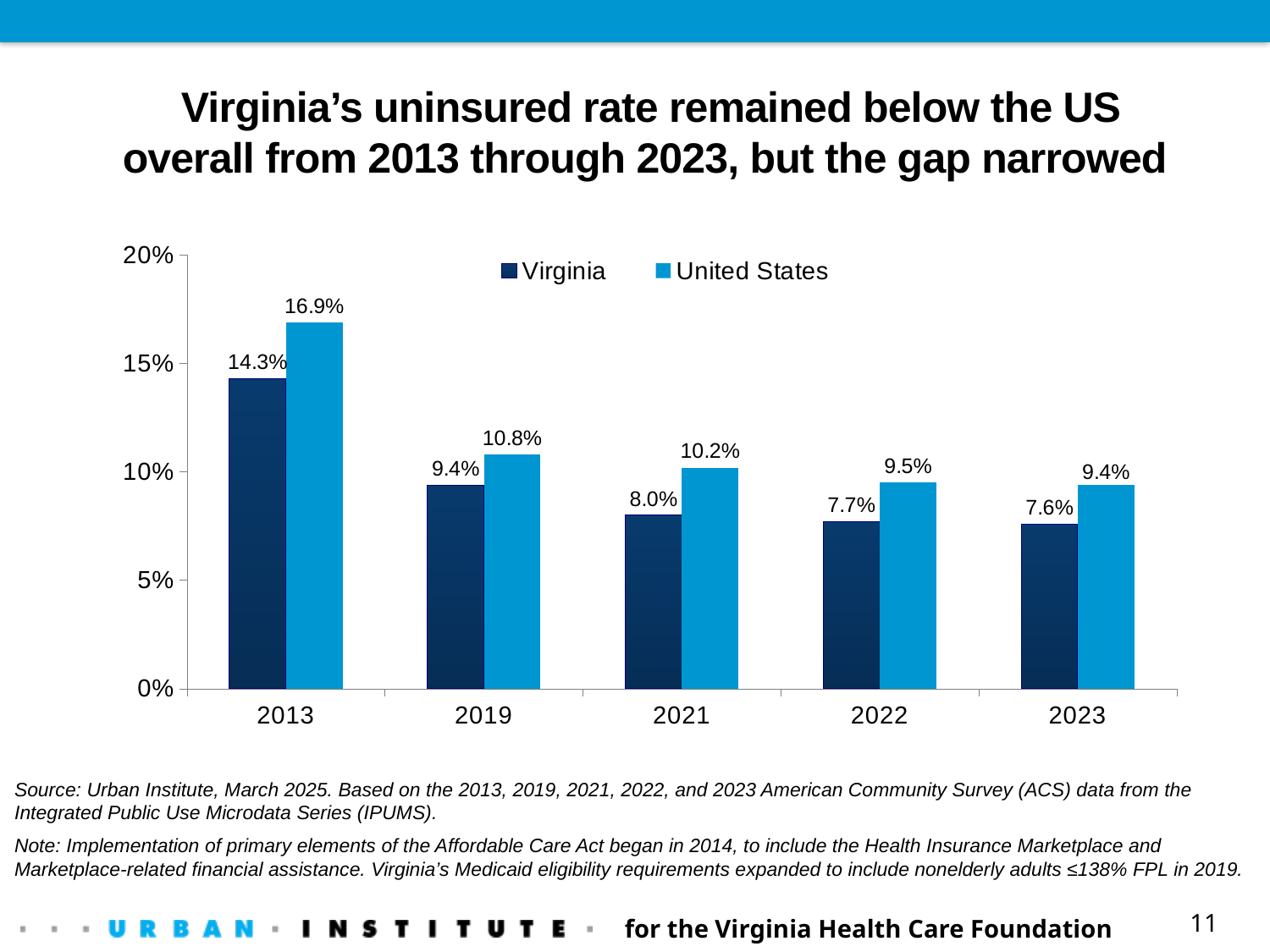
In which year was the United States uninsured rate highest? 2013 How many series does the legend list? 2 Which had the higher uninsured rate in 2019, Virginia or the United States? United States What was Virginia's uninsured rate in 2013? 14.3% In which year was Virginia's uninsured rate lowest? 2023 What is the difference between the United States and Virginia uninsured rates in 2023? 1.8% How many years are shown on the x axis? 5 What was Virginia's uninsured rate in 2023? 7.6% Does Virginia's uninsured rate rise or fall from 2013 to 2023? Fall What was the United States uninsured rate in 2021? 10.2% What is the difference between the United States and Virginia uninsured rates in 2013? 2.6% What kind of chart is shown on the slide? Bar chart